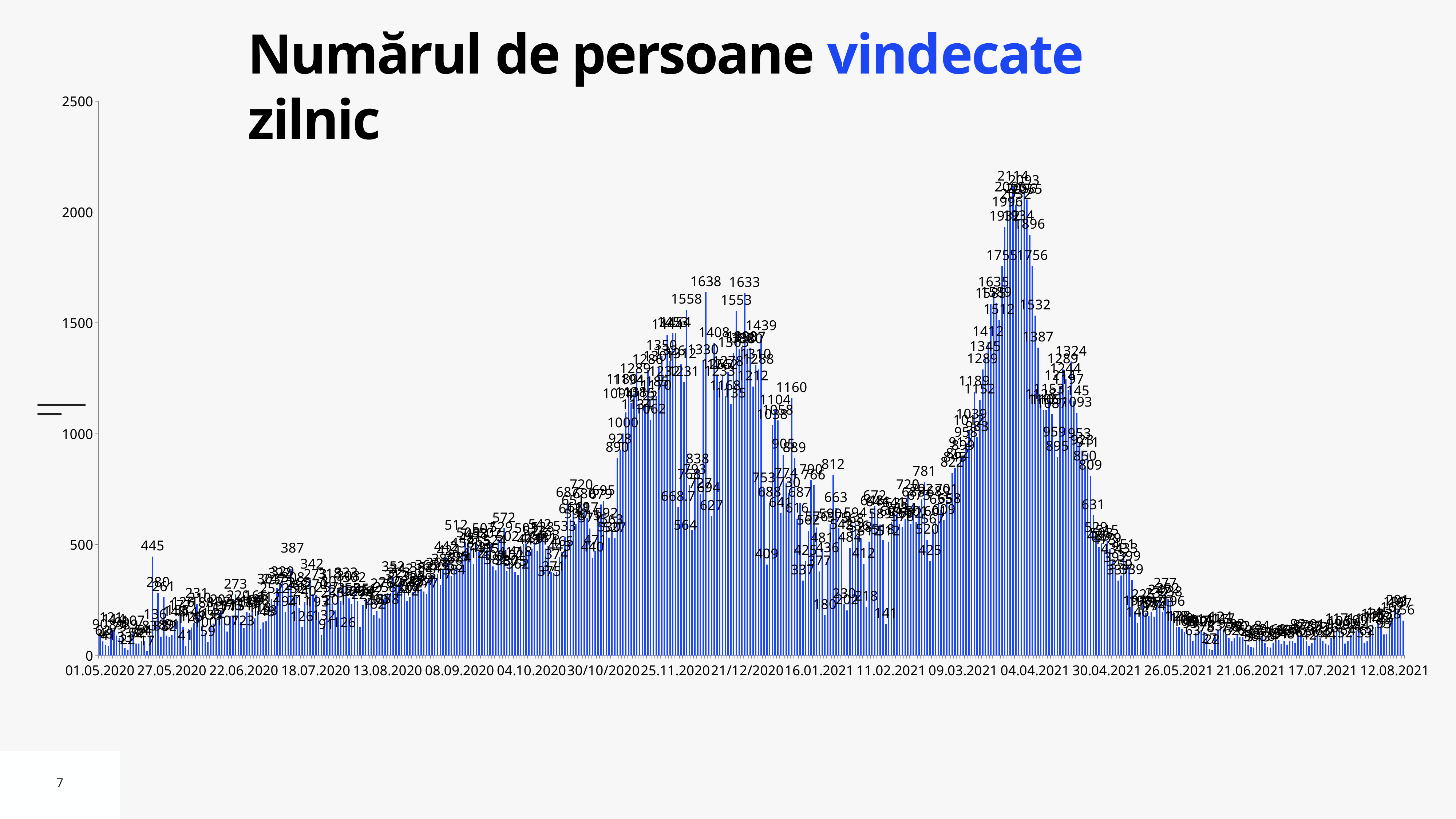
Is the tallest bar near 04.04.2021 greater or less than 2000? greater What is the highest data label shown on the chart? 2114 Is the value for 12.08.2021 greater or less than 500? less What is the highest data label shown in the peak around 25.11.2020? 1638 Do the values generally rise or fall between 09.03.2021 and 04.04.2021? rise What is the title of the chart? Numărul de persoane vindecate zilnic What is the highest tick value shown on the vertical axis? 2500 What is the difference between the highest data label of the chart (2114) and the highest data label of the peak around 25.11.2020 (1638)? 476 Do the values generally rise or fall between 04.04.2021 and 26.05.2021? fall Which peak is higher: the one around 04.04.2021 or the one around 25.11.2020? the one around 04.04.2021 Is the value for 01.05.2020 greater or less than 500? less What kind of chart is shown on the slide? bar chart